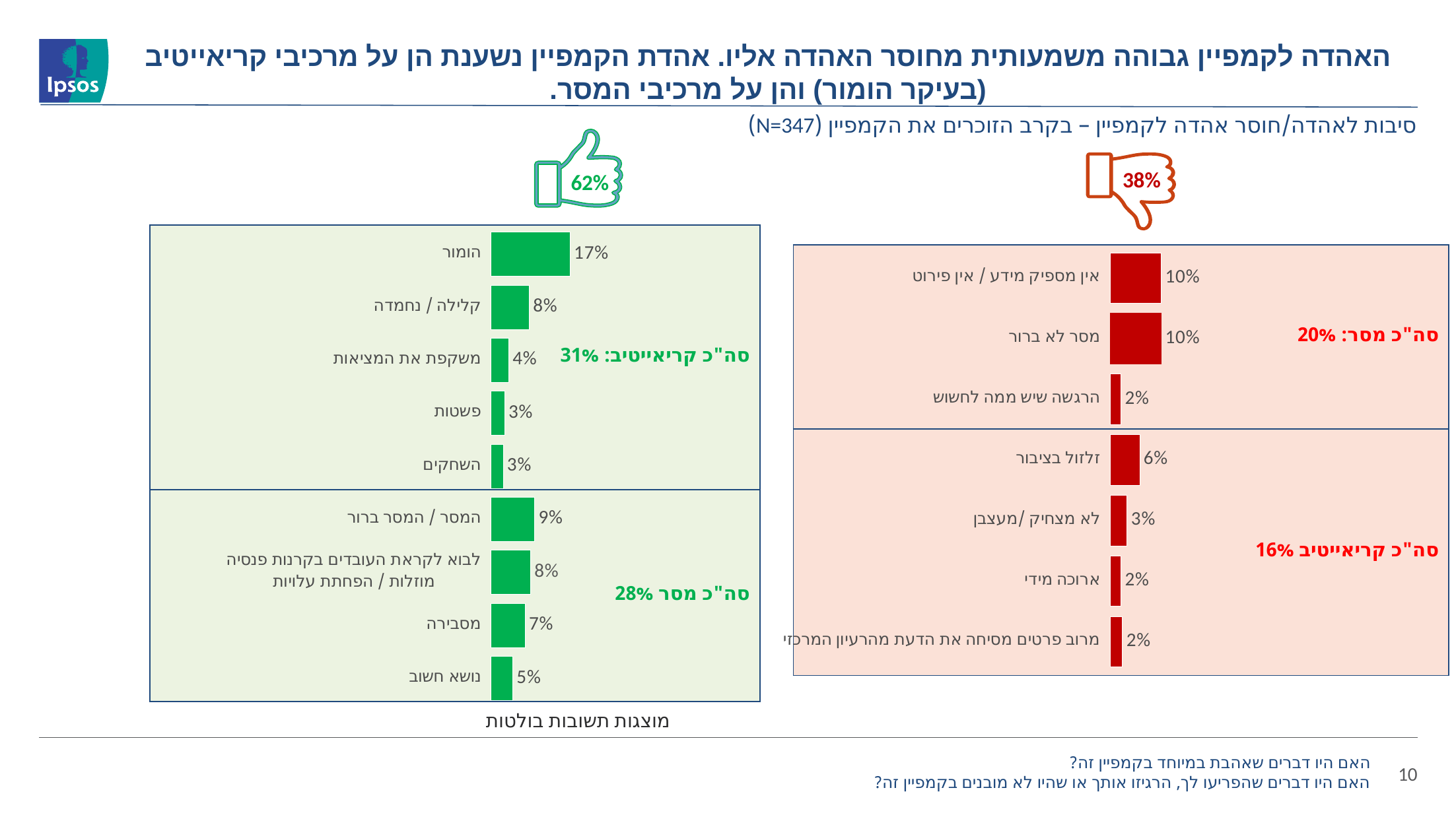
In the left (green) chart, what is the value for הומור? 17% In the right (red) chart, what is the value for זלזול בציבור? 6% How many categories are shown in the right (red) chart? 7 How many categories are shown in the left (green) chart? 9 In the left (green) chart, which category has the highest value? הומור What type of chart is the right (red) chart? Bar chart In the left (green) chart, what is the value for מסבירה? 7% In the right (red) chart, which category has the lowest value among זלזול בציבור, לא מצחיק /מעצבן and ארוכה מידי? ארוכה מידי What percentage is shown next to the thumbs-down icon above the right (red) chart? 38% In the left (green) chart, what is the difference between the values for הומור and קלילה / נחמדה? 9% In the left (green) chart, which is larger: the value for המסר / המסר ברור or the value for נושא חשוב? המסר / המסר ברור In the right (red) chart, what is the difference between the values for מסר לא ברור and הרגשה שיש ממה לחשוש? 8%